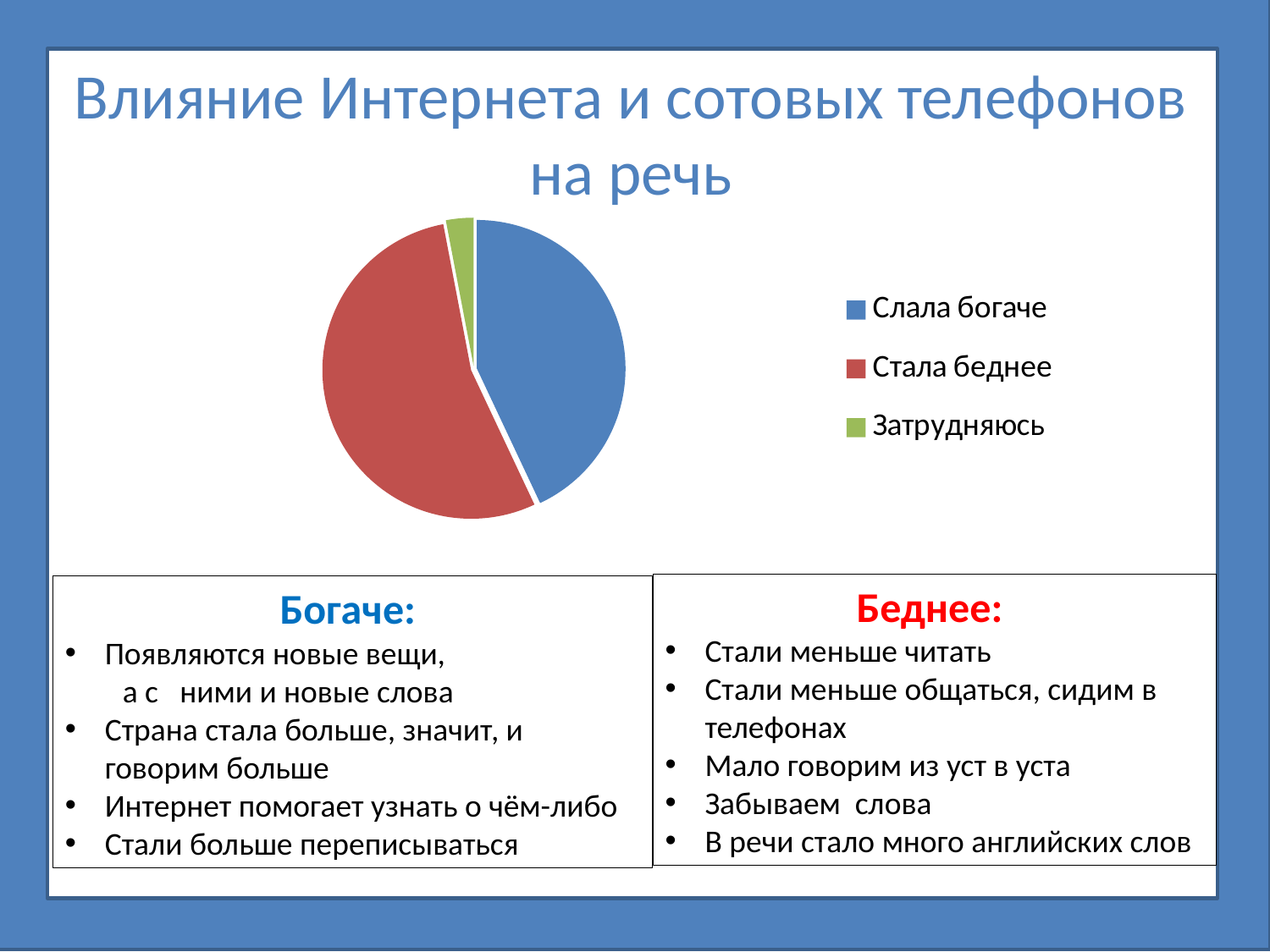
How many slices does the pie chart have? 3 Which category has the largest slice in the pie chart? Стала беднее What colour is the "Затрудняюсь" slice in the pie chart? Green What is the title of the chart on the slide? Влияние Интернета и сотовых телефонов на речь Which slice is larger: "Слала богаче" or "Затрудняюсь"? Слала богаче Which category has the smallest slice in the pie chart? Затрудняюсь What kind of chart is shown on the slide? Pie chart Which slice is larger: "Слала богаче" or "Стала беднее"? Стала беднее How many entries does the legend of the pie chart list? 3